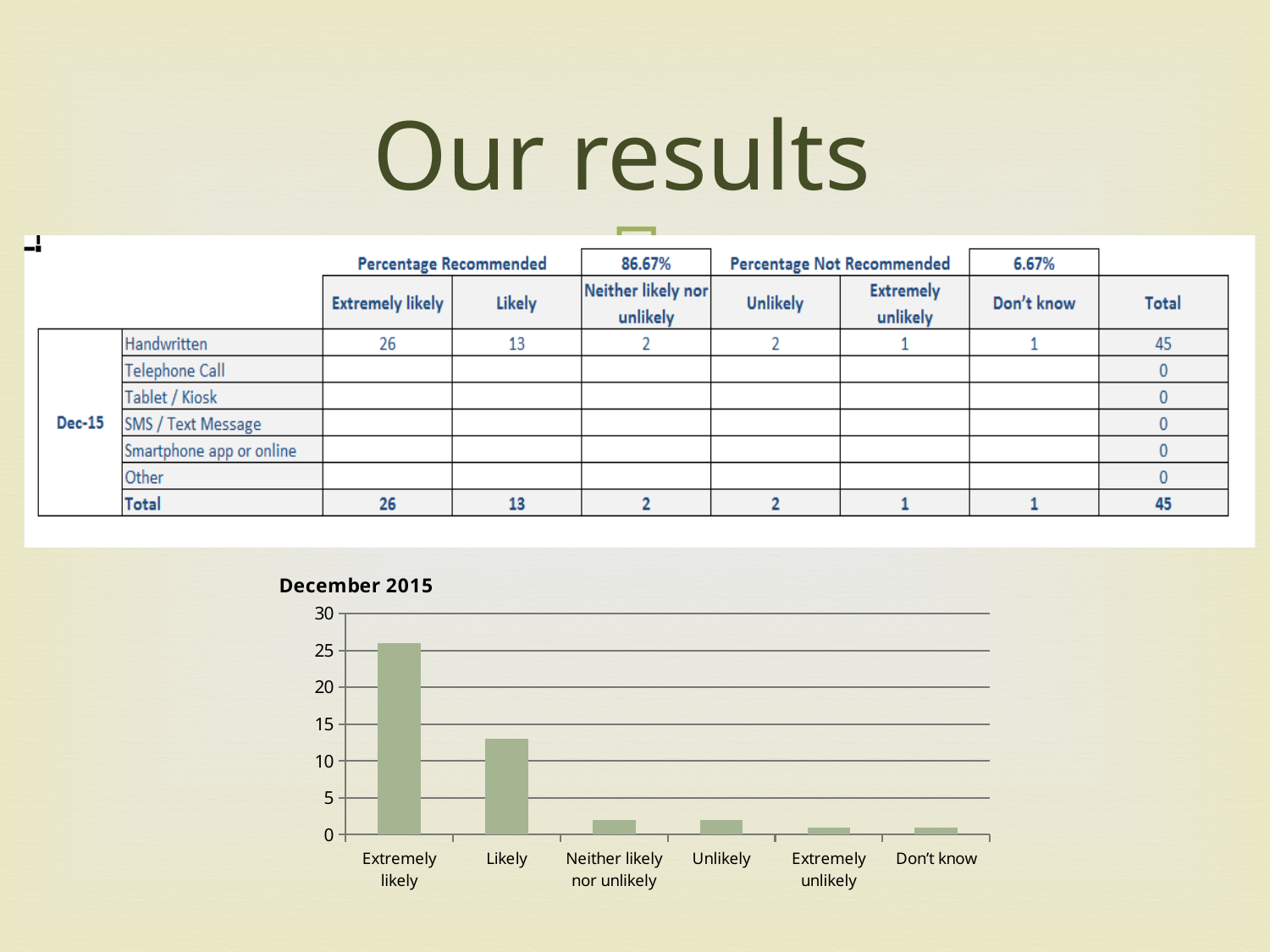
What is the title of the chart? December 2015 Which is larger, the value for Extremely likely or the value for Likely? Extremely likely What is the highest value shown on the y axis of the chart? 30 What kind of chart is shown on the slide? bar chart Is the value for Likely greater or less than 10? greater Is the value for Unlikely greater or less than 5? less How many categories are shown on the x axis of the chart? 6 Do the bar values generally rise or fall from left to right along the x axis? fall Which is larger, the value for Likely or the value for Unlikely? Likely Which category has the highest bar in the chart? Extremely likely Is the value for Likely greater or less than 15? less